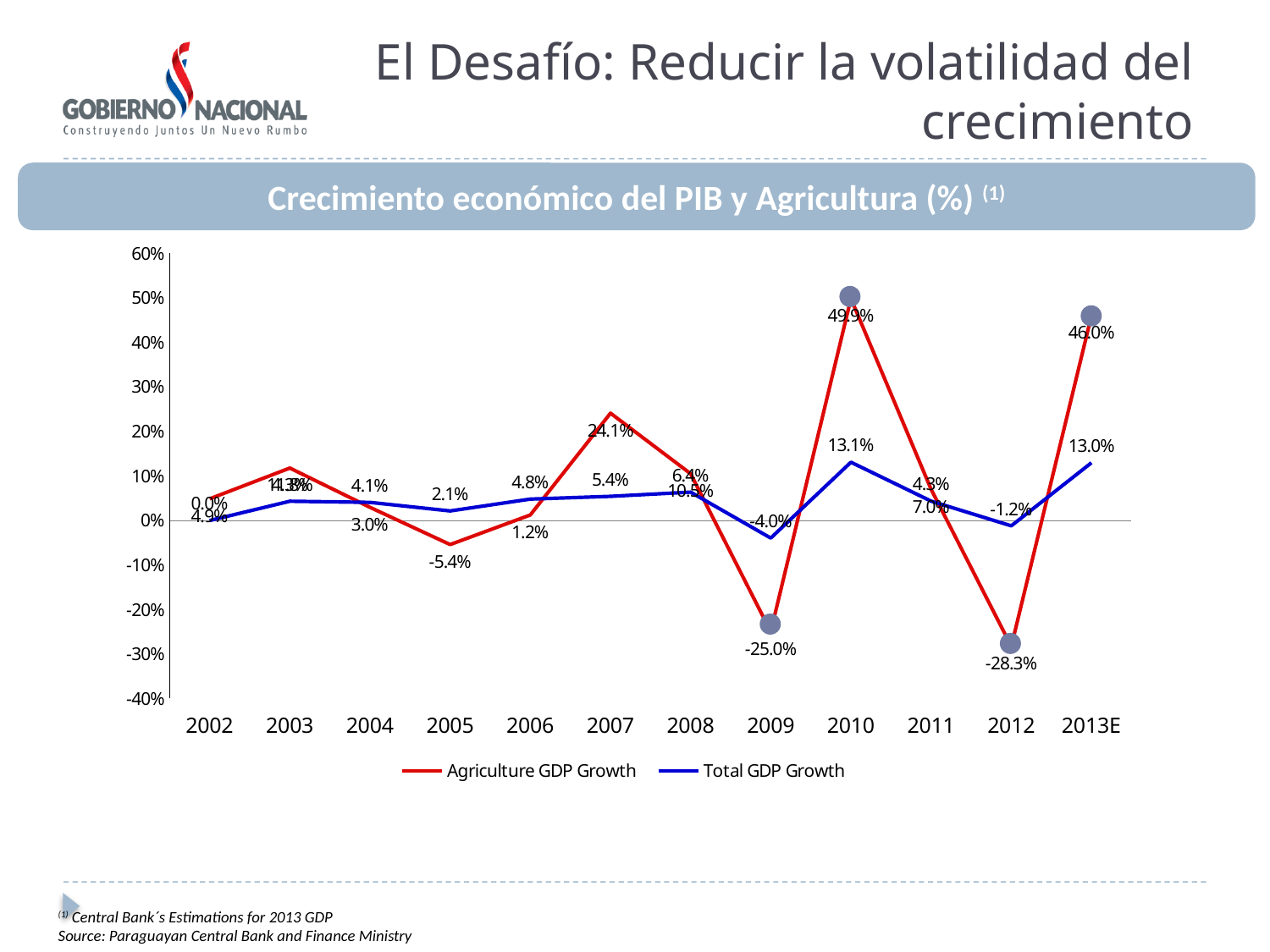
In which year is Agriculture GDP Growth highest? 2010 What is the Total GDP Growth value for 2013E? 13.0% In 2007, which is larger: Agriculture GDP Growth or Total GDP Growth? Agriculture GDP Growth What is the Agriculture GDP Growth value for 2012? -28.3% What kind of chart is shown on the slide? line chart How many series does the legend list? 2 How many years are plotted along the x axis? 12 Is the Agriculture GDP Growth value for 2013E greater or less than 40%? greater In which year is Agriculture GDP Growth lowest? 2012 What is the Agriculture GDP Growth value for 2005? -5.4% What is the difference between Agriculture GDP Growth and Total GDP Growth in 2010? 36.8 percentage points What is the Agriculture GDP Growth value for 2010? 49.9%